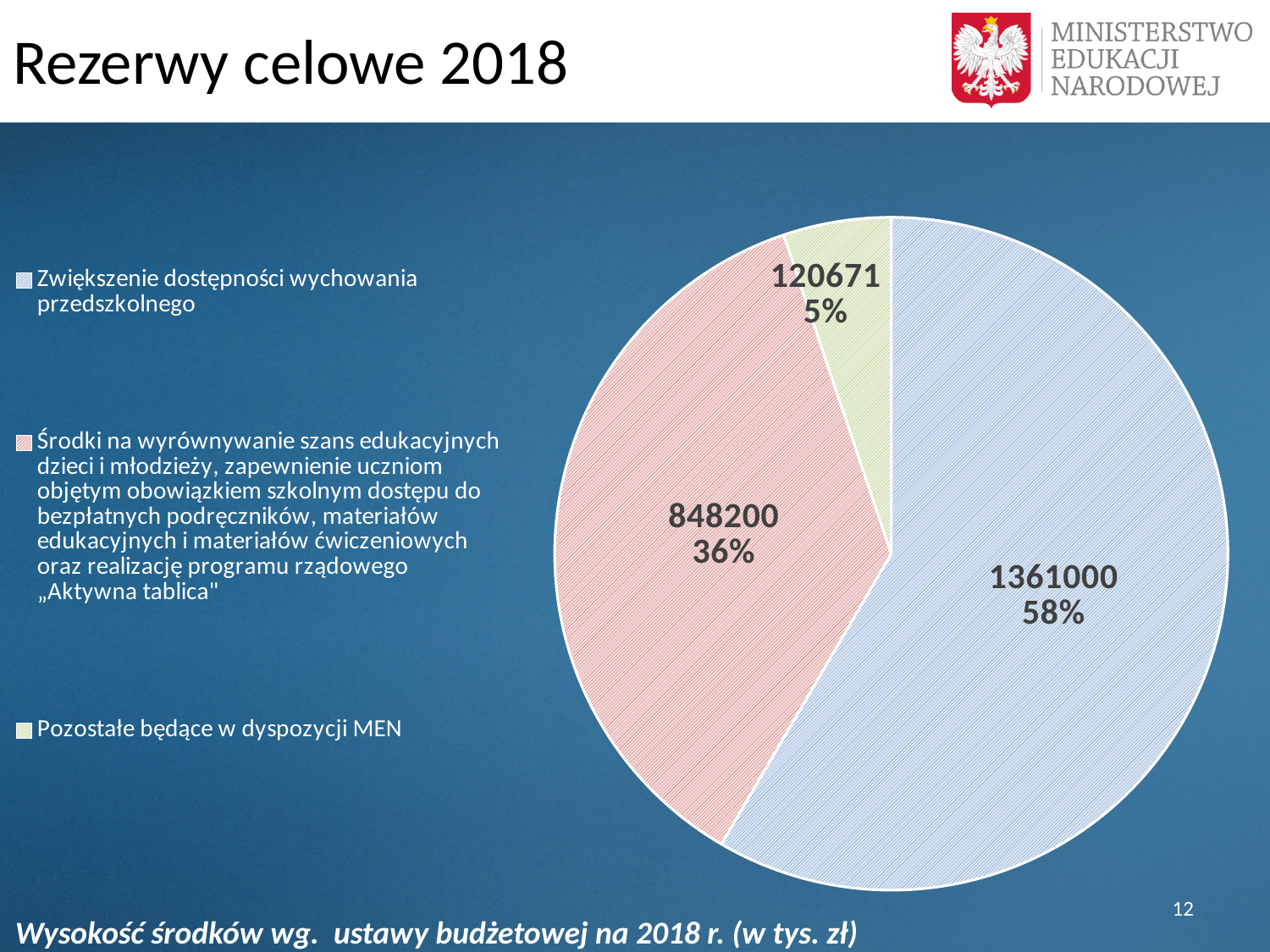
What is the value for "Środki na wyrównywanie szans edukacyjnych dzieci i młodzieży..."? 848200 How many entries does the legend list? 3 What is the value for "Zwiększenie dostępności wychowania przedszkolnego"? 1361000 What share of the pie does "Pozostałe będące w dyspozycji MEN" represent? 5% Which category has the largest slice of the pie? Zwiększenie dostępności wychowania przedszkolnego Which category has the smallest slice of the pie? Pozostałe będące w dyspozycji MEN What is the difference between the value for "Zwiększenie dostępności wychowania przedszkolnego" and the value for "Środki na wyrównywanie szans edukacyjnych..."? 512800 How many slices does the pie chart have? 3 What kind of chart is shown on the slide? pie chart What is the value for "Pozostałe będące w dyspozycji MEN"? 120671 What share of the pie does "Zwiększenie dostępności wychowania przedszkolnego" represent? 58% Which is larger: the value for "Środki na wyrównywanie szans edukacyjnych..." or the value for "Pozostałe będące w dyspozycji MEN"? Środki na wyrównywanie szans edukacyjnych...